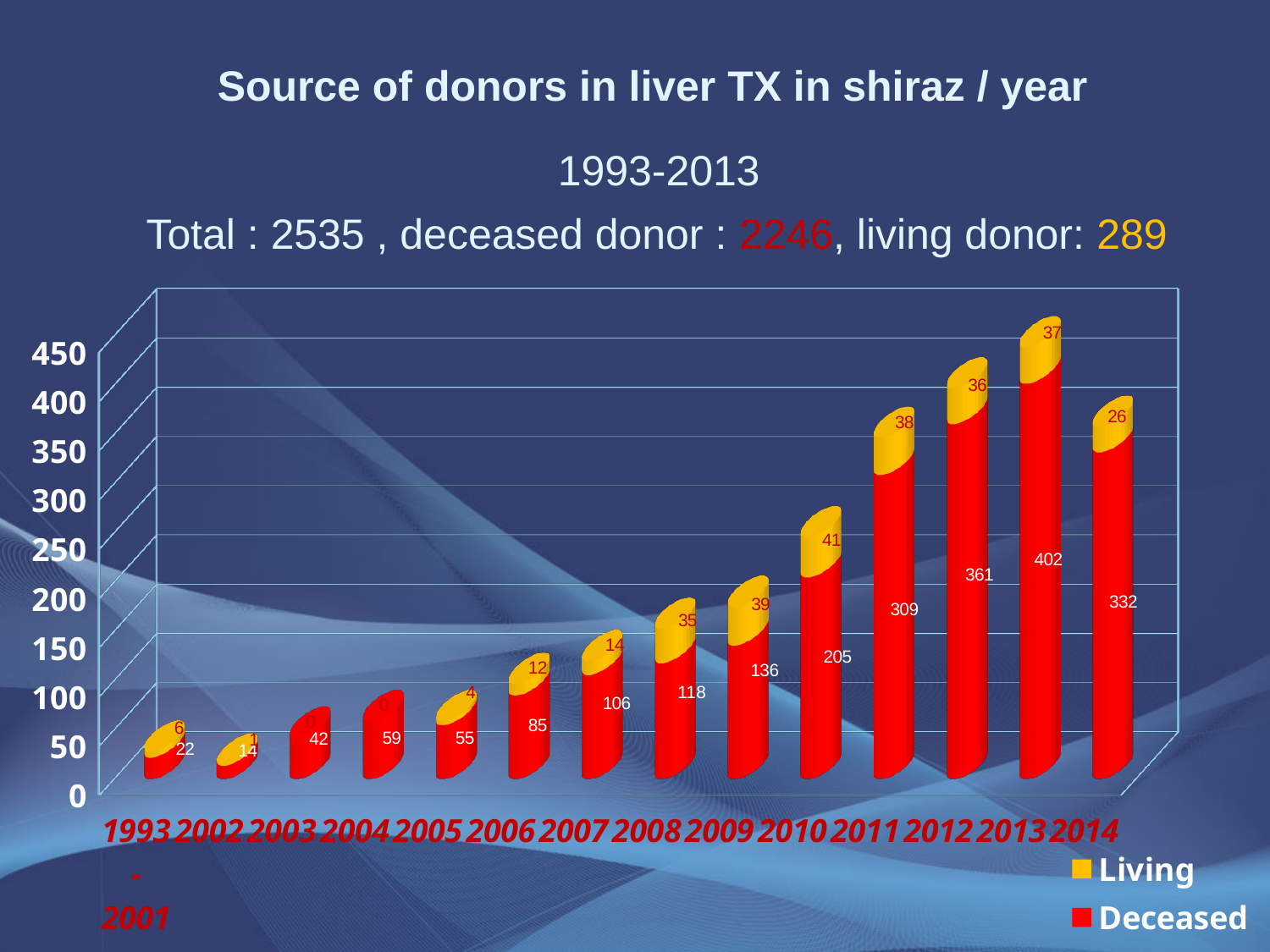
What is the Deceased value for 2006? 85 How many categories are shown on the x axis? 14 What kind of chart is shown on the slide? Stacked bar chart What is the difference between the Deceased values for 2013 and 2012? 41 What is the Living value for 2010? 41 How many series does the legend list? 2 What is the Deceased value for 2013? 402 Which category has the lowest Deceased value? 2002 Which is larger, the Deceased value for 2011 or for 2014? 2014 What is the total of the stacked bar for 2013 (Deceased plus Living)? 439 Which colour represents the Living series in the legend? Yellow Which year has the highest Deceased value? 2013